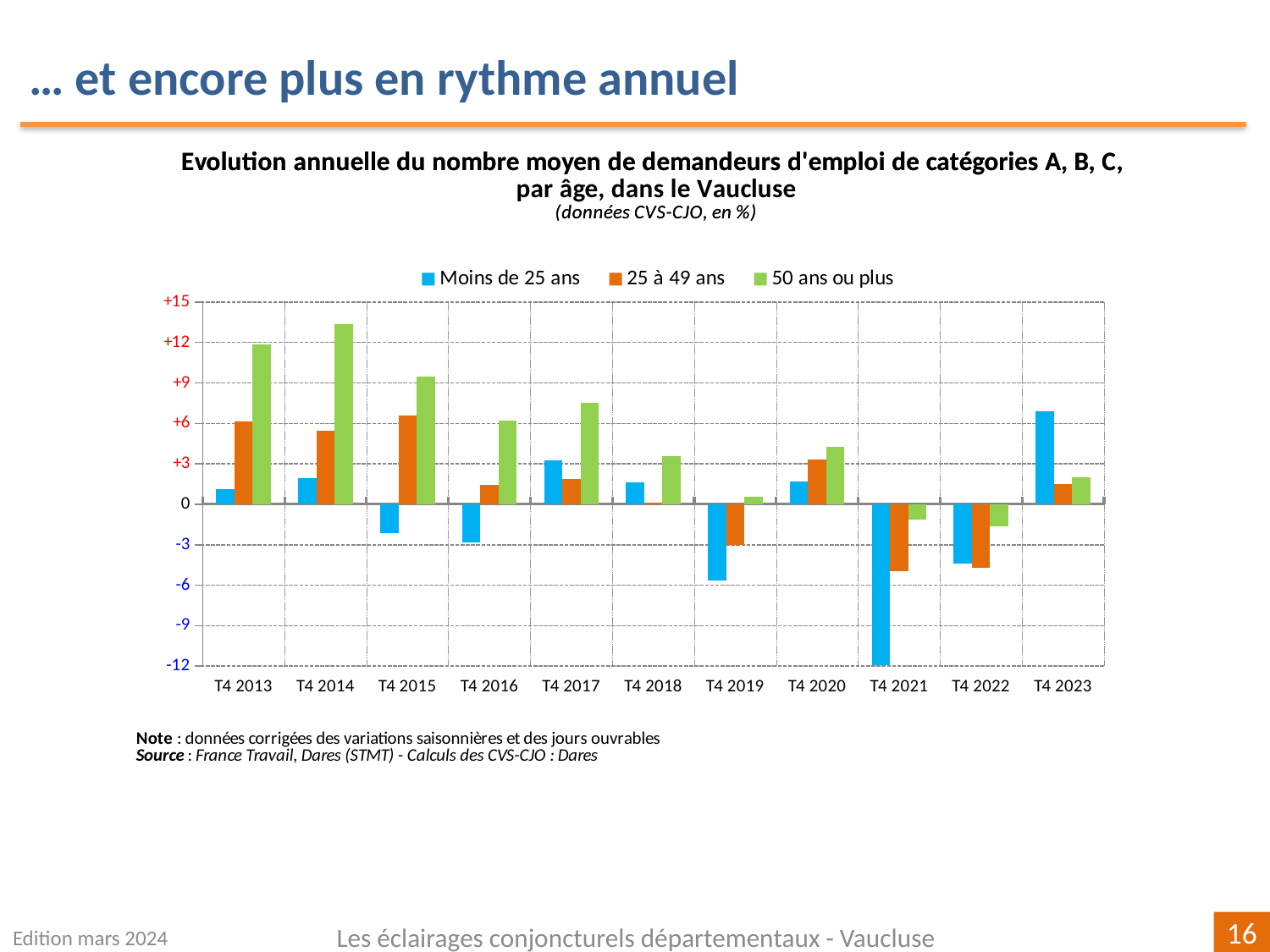
What colour represents the '50 ans ou plus' series in the legend? green In which quarter is the value for '50 ans ou plus' the highest? T4 2014 In T4 2015, which is larger: the value for '25 à 49 ans' or for '50 ans ou plus'? 50 ans ou plus Is the value for '50 ans ou plus' in T4 2013 greater or less than +9? greater Is the value for 'Moins de 25 ans' in T4 2019 greater or less than -3? less How many quarters (categories) are shown on the x axis? 11 In which quarter is the value for 'Moins de 25 ans' the highest? T4 2023 In T4 2023, which is larger: the value for 'Moins de 25 ans' or for '25 à 49 ans'? Moins de 25 ans How many series does the legend list? 3 What kind of chart is shown on the slide? bar chart Is the value for 'Moins de 25 ans' in T4 2021 greater or less than -9? less In which quarter is the value for 'Moins de 25 ans' the lowest? T4 2021